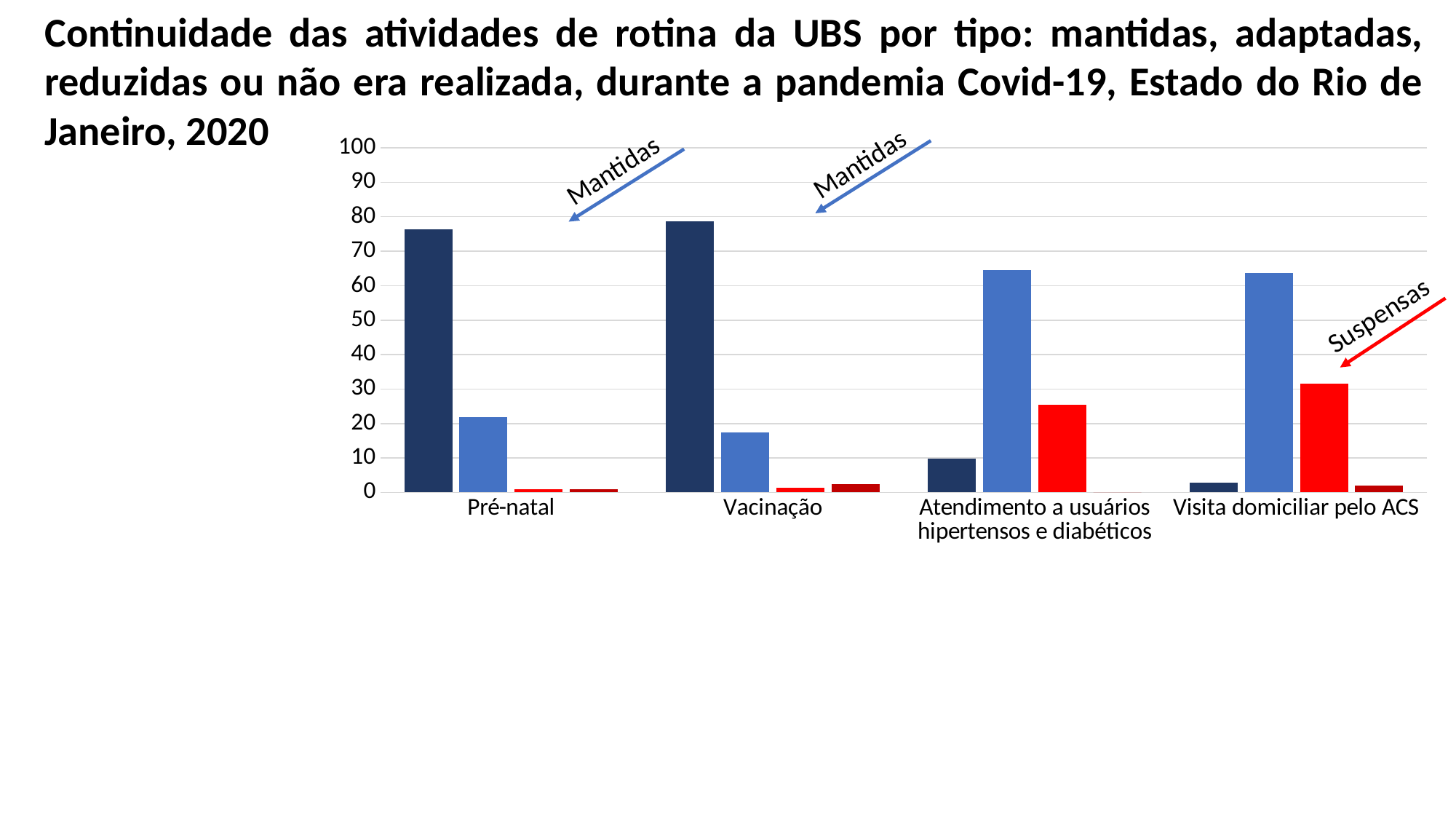
What label is written next to the red arrow pointing at the Visita domiciliar pelo ACS bars? Suspensas How many categories are shown on the x axis of the chart? 4 Which is larger: the red bar for Atendimento a usuários hipertensos e diabéticos or the red bar for Visita domiciliar pelo ACS? Visita domiciliar pelo ACS Is the value of the medium blue bar for Atendimento a usuários hipertensos e diabéticos greater or less than 60? greater What kind of chart is shown on the slide? bar chart Which category has the shortest dark navy bar? Visita domiciliar pelo ACS Is the value of the medium blue bar for Pré-natal greater or less than 30? less Which category has the tallest red bar? Visita domiciliar pelo ACS Is the value of the dark navy bar for Vacinação greater or less than 70? greater Which is larger: the medium blue bar for Pré-natal or the medium blue bar for Vacinação? Pré-natal